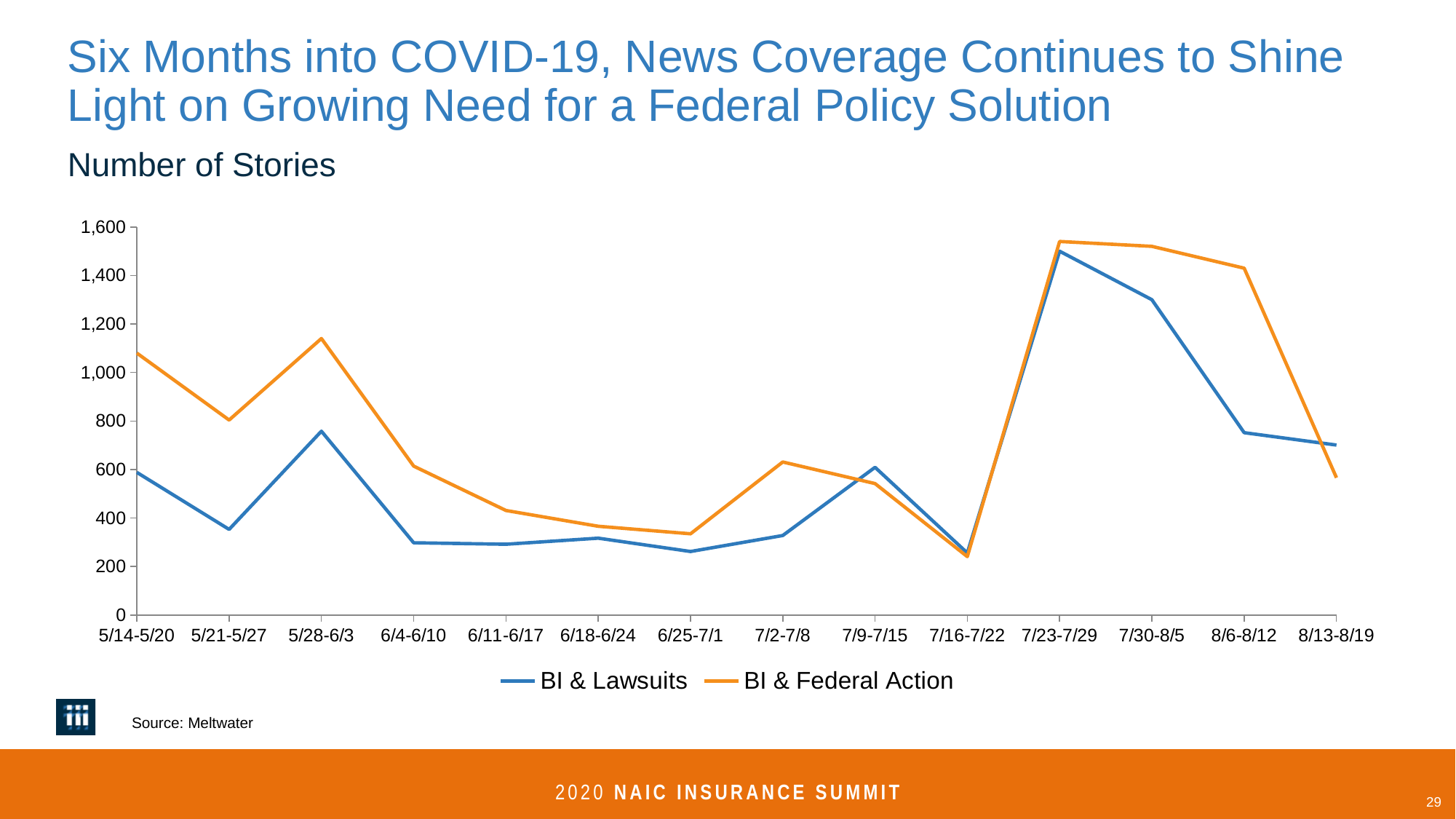
How many series does the legend list? 2 Does the BI & Federal Action series rise or fall from the week 7/23-7/29 to the week 8/13-8/19? fall In which week does the BI & Lawsuits series reach its highest value? 7/23-7/29 In which week does the BI & Federal Action series reach its highest value? 7/23-7/29 What type of chart is shown on the slide? Line chart Is the value for BI & Lawsuits in the week 5/21-5/27 greater or less than 400? less How many weekly periods are shown on the x axis? 14 In which week does the BI & Federal Action series reach its lowest value? 7/16-7/22 Which series has the higher value in the week 8/13-8/19? BI & Lawsuits Is the value for BI & Lawsuits in the week 7/23-7/29 greater or less than 1,400? greater Which series has the higher value in the week 5/14-5/20? BI & Federal Action Is the value for BI & Federal Action in the week 5/14-5/20 greater or less than 1,000? greater